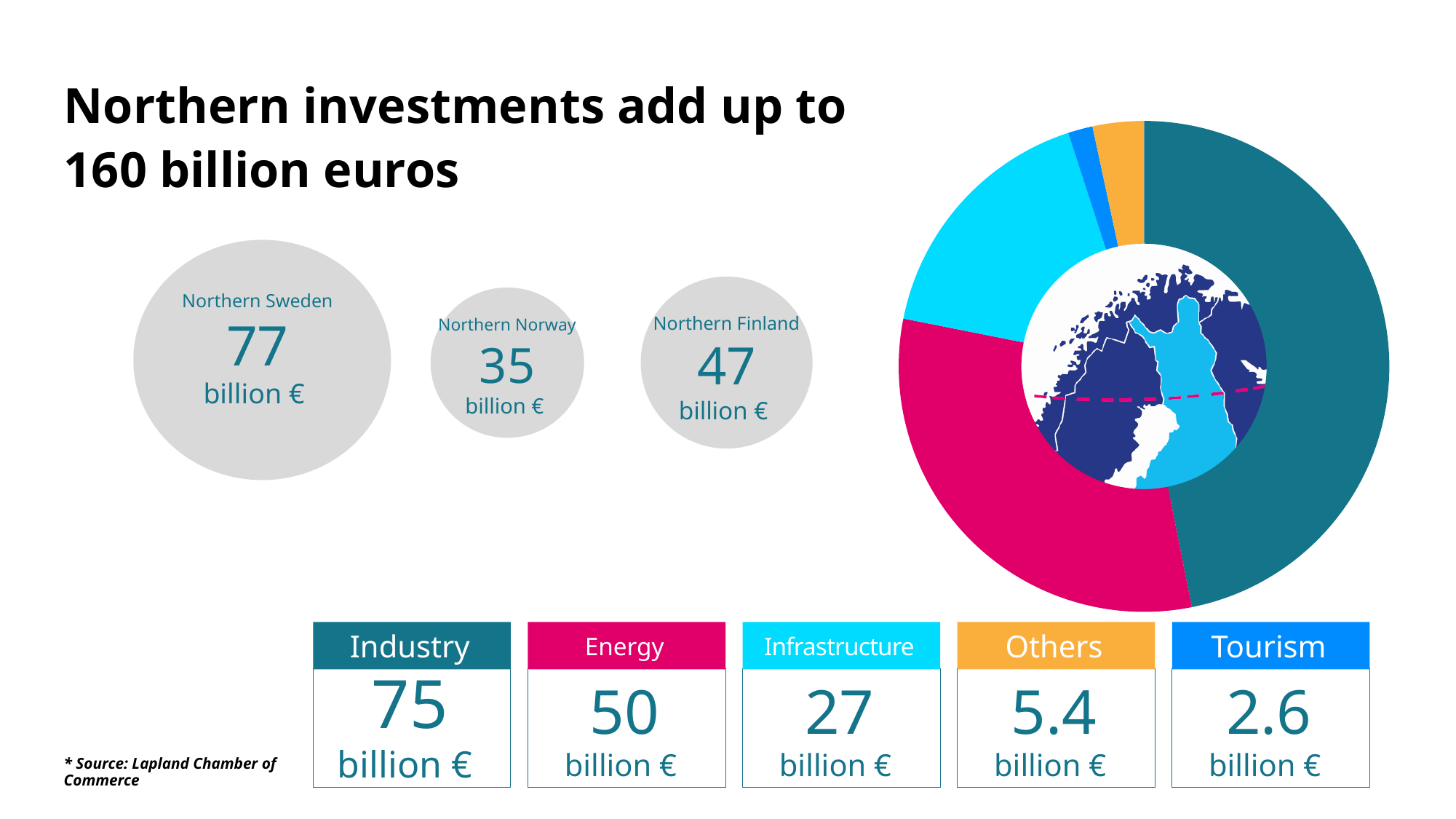
Which sector has the smallest value in the donut chart? Tourism In the donut chart, what is the value for Energy? 50 billion € What colour represents Energy in the donut chart? Magenta/pink In the donut chart, what is the value for Industry? 75 billion € What is the total of all sectors in the donut chart? 160 billion € Which is larger in the donut chart, Infrastructure or Others? Infrastructure In the regional circles on the left, which region has the highest investment value? Northern Sweden Which sector has the largest value in the donut chart? Industry In the donut chart, what is the value for Tourism? 2.6 billion € How many sectors does the donut chart show? 5 What is the difference between the Industry and Energy values in the donut chart? 25 billion € What type of chart is shown on the right of the slide? Pie chart (donut)